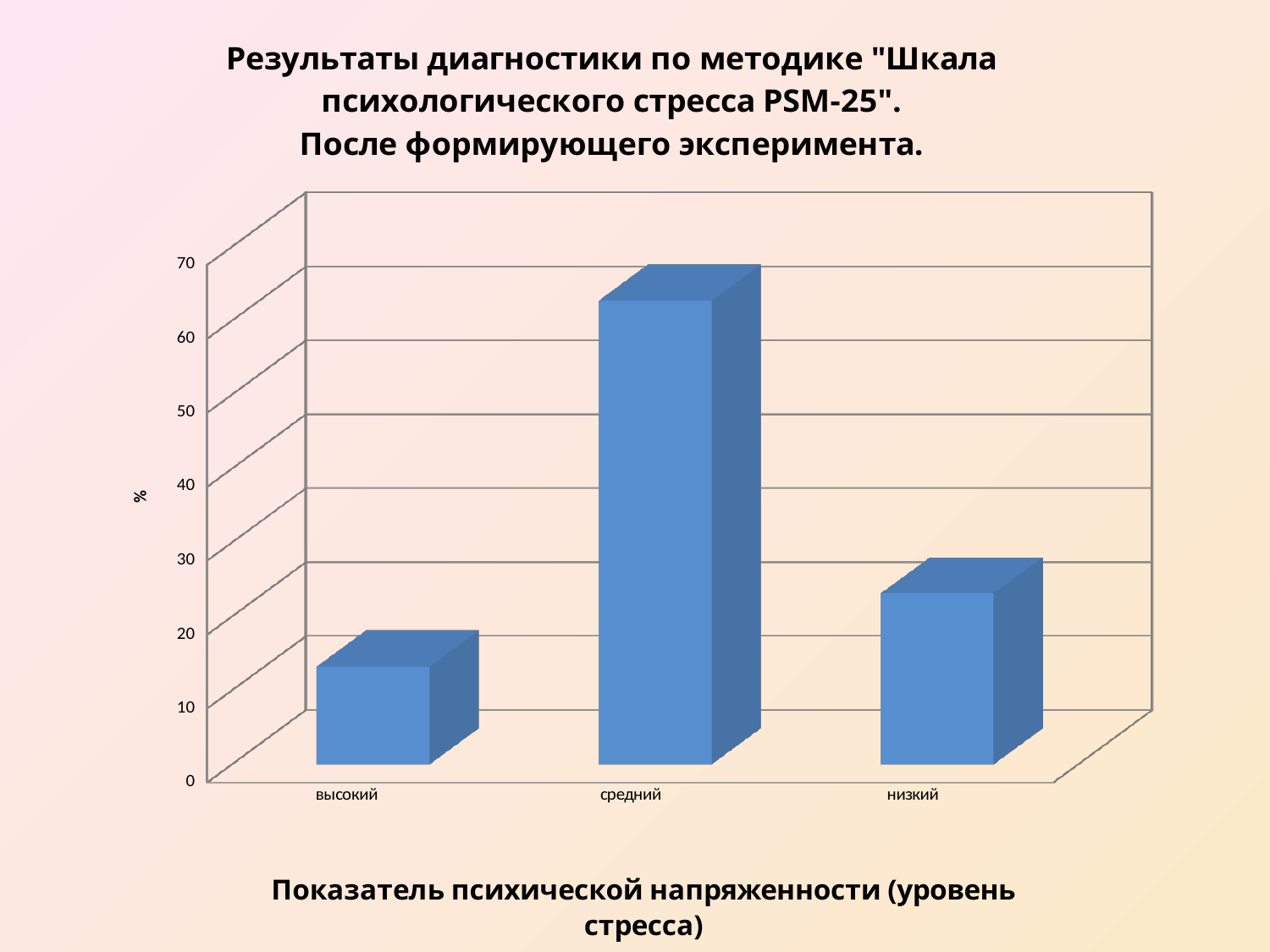
What is the label on the vertical axis of the chart? % Is the value for низкий greater or less than 30? less How many categories are shown on the x axis of the chart? 3 Which is larger, the value for низкий or the value for высокий? низкий Which category has the lowest bar? высокий Is the value for средний greater or less than 50? greater Is the value for высокий greater or less than 20? less Which category has the highest bar? средний Which is larger, the value for средний or the value for низкий? средний What is the title written below the chart? Показатель психической напряженности (уровень стресса) What kind of chart is shown on the slide? bar chart